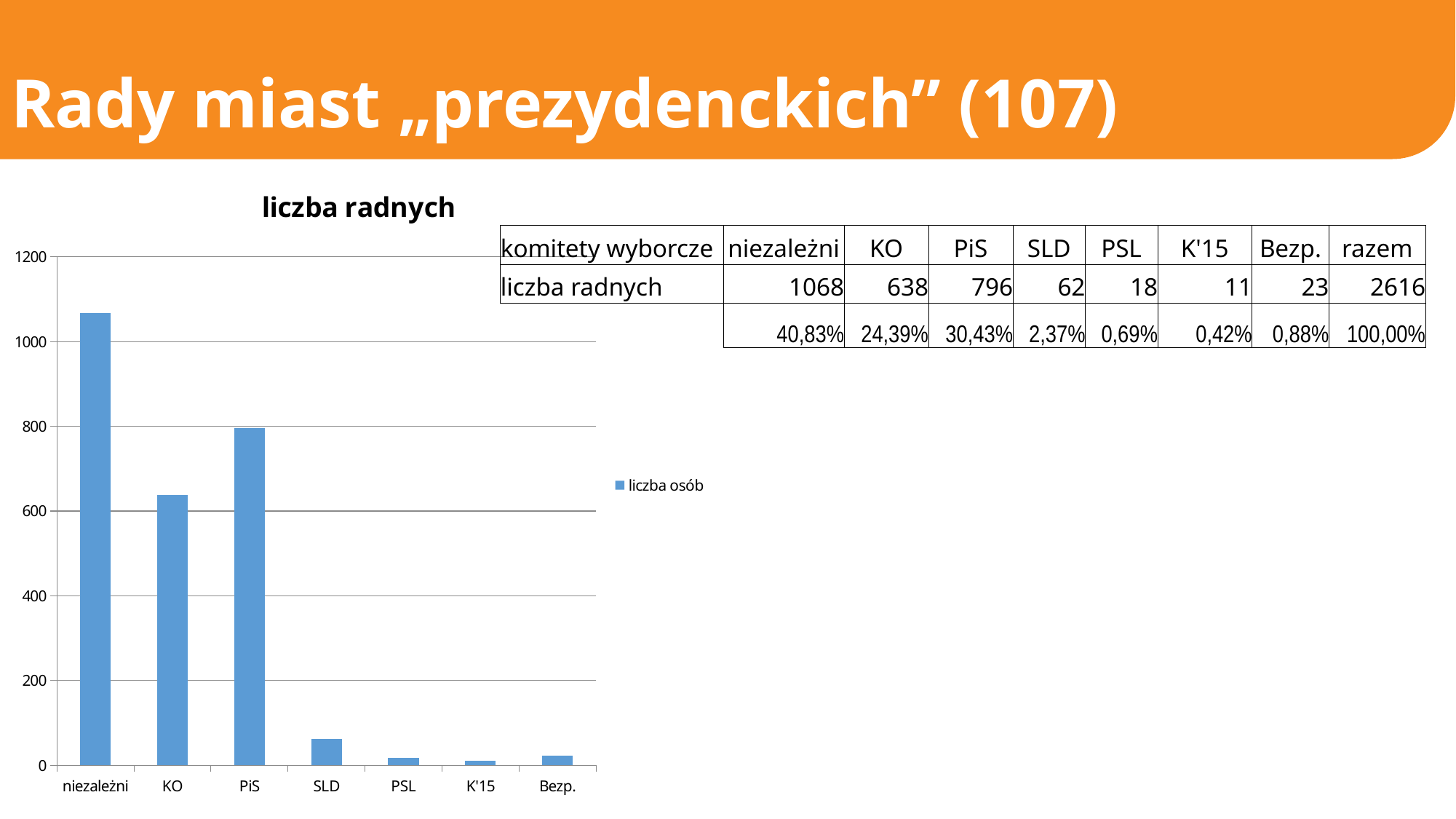
According to the table on the slide, what percentage share does SLD have? 2,37% Is the bar for niezależni greater or less than 1000? greater Which category has the highest bar in the chart? niezależni According to the table on the slide, what is the number of councillors (liczba radnych) for KO? 638 What type of chart is shown on the slide? bar chart Which bar is taller, KO or PiS? PiS According to the table on the slide, what is the difference between the number of councillors for niezależni and PiS? 272 Which category has the lowest bar in the chart? K'15 What is the title of the chart? liczba radnych How many series does the chart legend list? 1 How many categories are shown on the x axis of the chart? 7